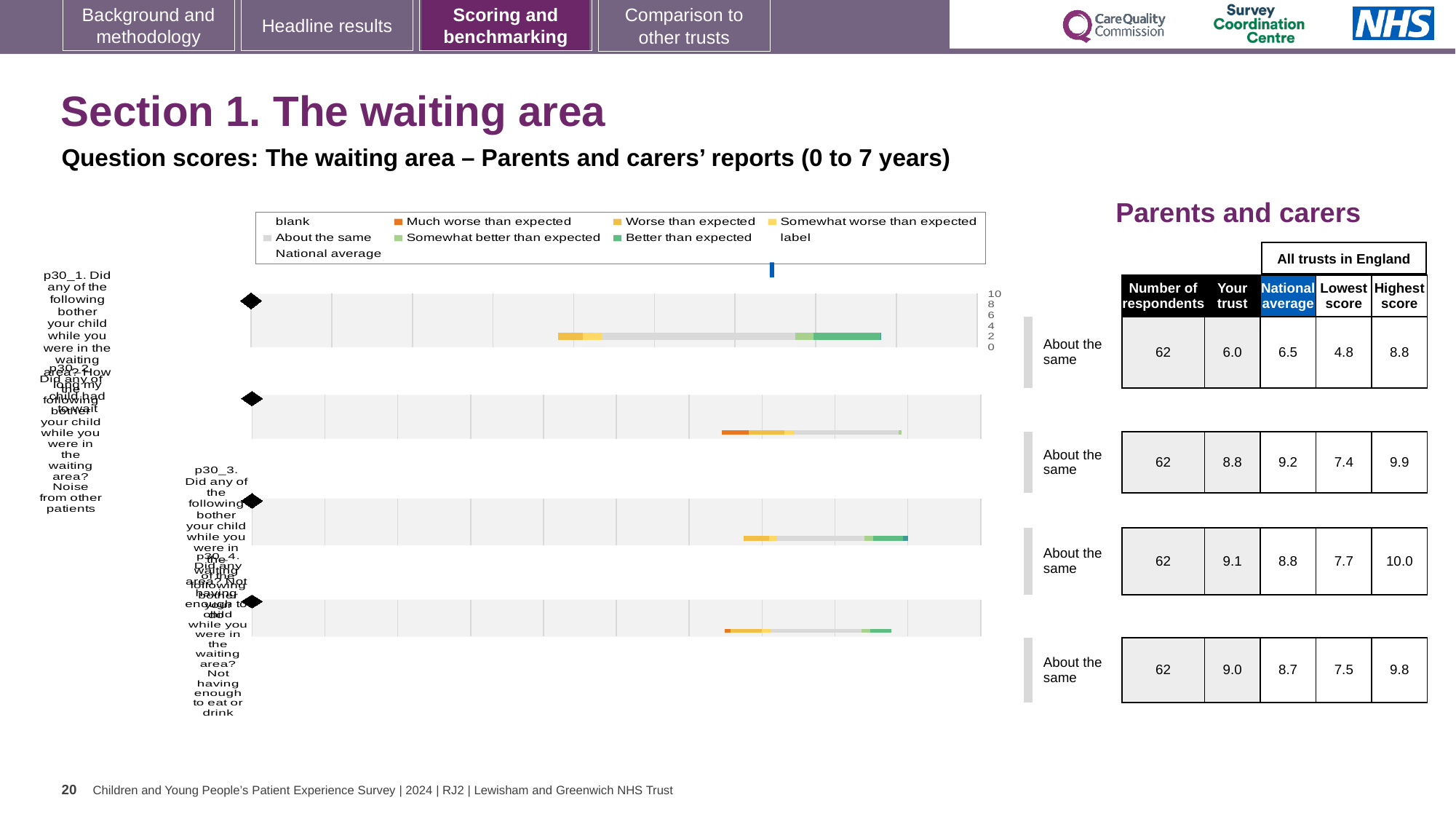
Which question has the highest 'Your trust' score? p30_3 (Not having enough to do) How many questions (bars) are plotted in the chart? 4 How many respondents answered each of the four questions? 62 What is the 'Your trust' score for p30_1 (Did any of the following bother your child while you were in the waiting area? Length of time to wait)? 6.0 What is the national average score for p30_2 (Noise from other patients)? 9.2 What is the difference between the national average and the 'Your trust' score for p30_1? 0.5 Which colour does the legend use for 'Better than expected'? green What is the highest score across all trusts in England for p30_3 (Not having enough to do)? 10.0 Which colour does the legend use for 'Much worse than expected'? orange What is the lowest score across all trusts in England for p30_4 (Not having enough to eat or drink)? 7.5 Which question has the lowest 'Your trust' score? p30_1 (Length of time to wait) What kind of chart is used to show the question scores on this slide? bar chart